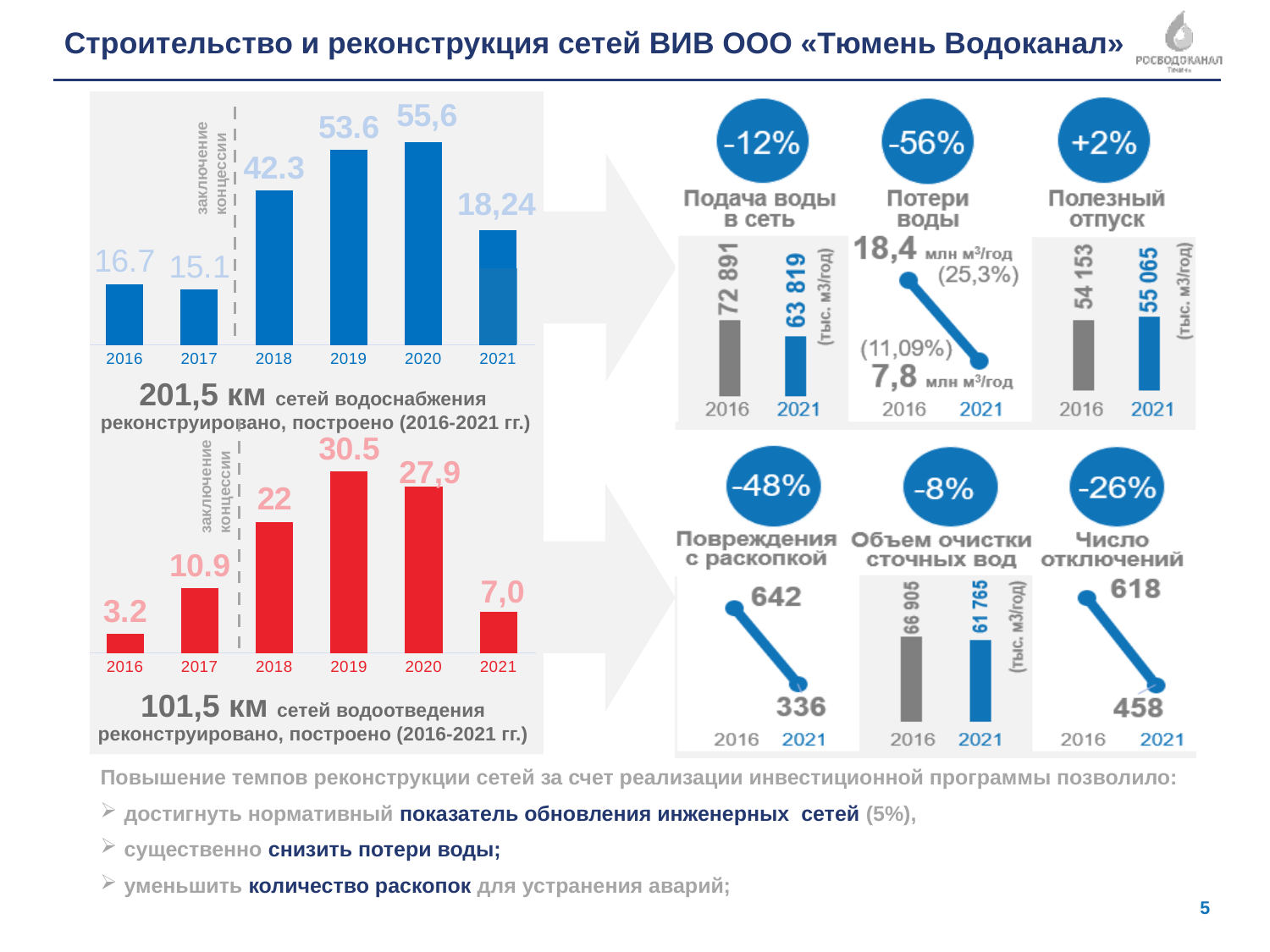
In the top-left blue bar chart (water supply networks), which year has the highest value? 2020 In the top-left blue bar chart (water supply networks), which year has the lowest value? 2017 In the top-left blue bar chart (water supply networks), what is the value for 2021? 18,24 In the top-left blue bar chart (water supply networks), what is the difference between the 2019 and 2018 values? 11.3 In the small chart titled «Подача воды в сеть», what is the value for 2021? 63 819 In the top-left blue bar chart (water supply networks), what is the value for 2019? 53.6 In the bottom-left red bar chart (wastewater networks), which year has the highest value? 2019 How many years (categories) are shown in the bottom-left red bar chart? 6 In the bottom-left red bar chart (wastewater networks), which is larger, the value for 2020 or the value for 2021? 2020 What type of chart is the top-left chart showing water supply network values by year? bar chart In the bottom-left red bar chart (wastewater networks), what is the value for 2016? 3.2 In the small chart titled «Повреждения с раскопкой», what is the difference between the 2016 and 2021 values? 306